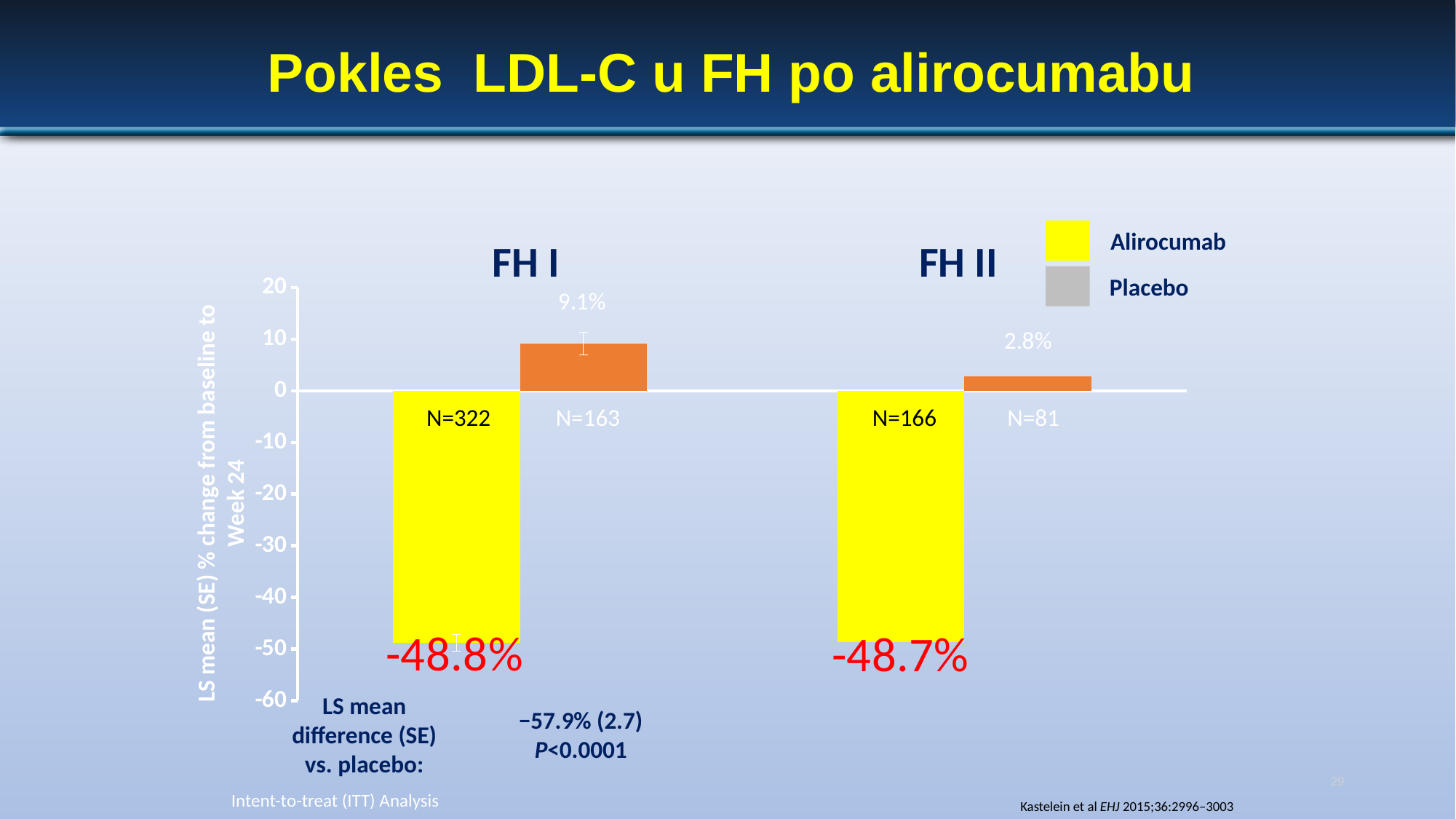
How many patients were in the placebo arm of the FH II study? N=81 What is the LS mean % change from baseline for alirocumab in the FH I study? -48.8% What is the difference between the placebo values in FH I and FH II? 6.3% How many patients were in the alirocumab arm of the FH I study? N=322 How many series does the legend list? 2 What type of chart is shown on the slide? Bar chart What is the LS mean % change from baseline for placebo in the FH I study? 9.1% Is the alirocumab value in FH I greater or less than -40? less What is the LS mean % change from baseline for placebo in the FH II study? 2.8% Which placebo bar is higher, FH I or FH II? FH I What is the LS mean % change from baseline for alirocumab in the FH II study? -48.7% What is the LS mean difference (SE) vs. placebo shown for FH I? −57.9% (2.7)